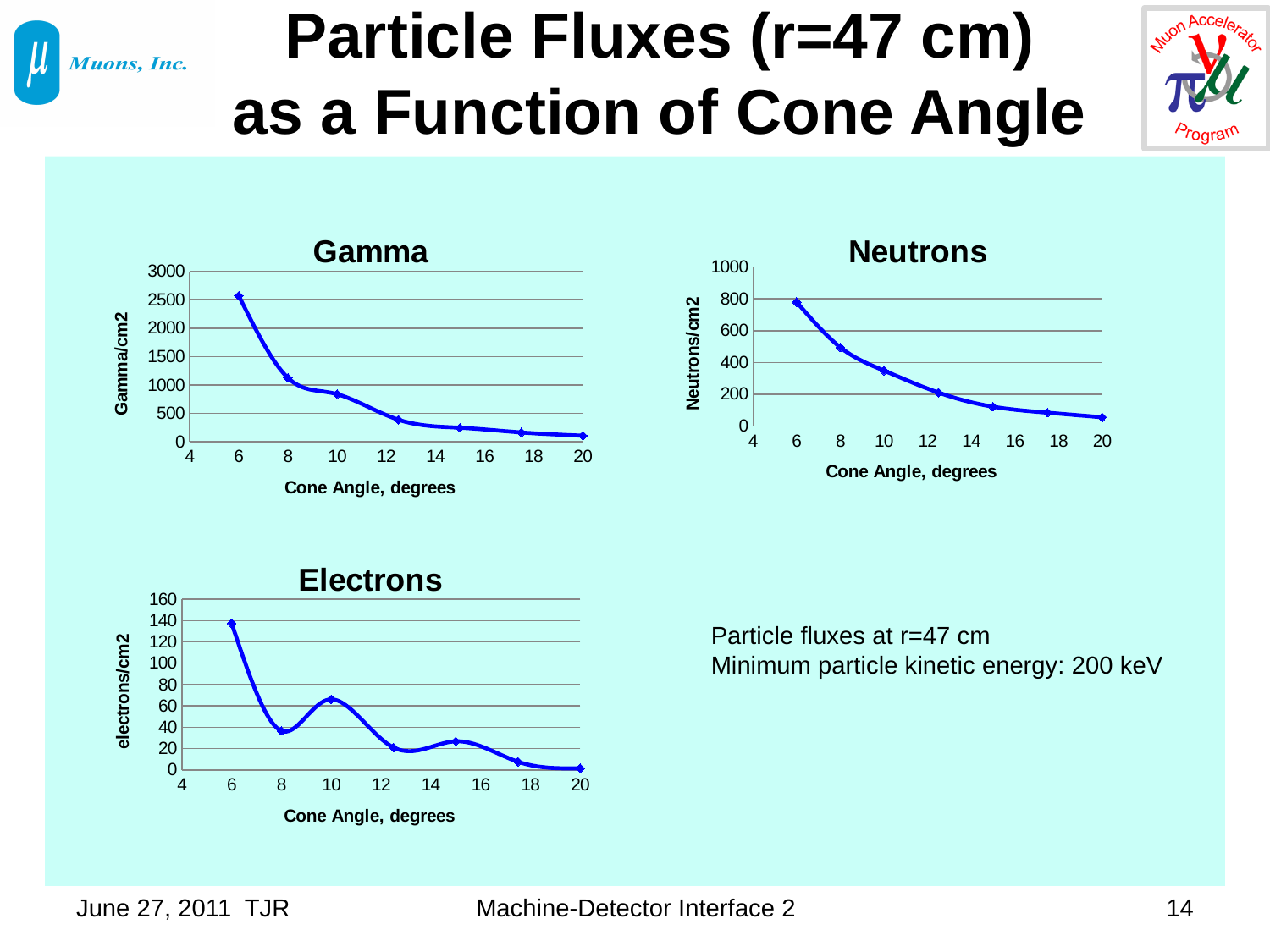
What kind of chart is the Gamma chart? line chart On the Neutrons chart, is the value at a cone angle of 20 degrees greater or less than 200? less On the Electrons chart, is the value at a cone angle of 6 degrees greater or less than 120? greater What is the x-axis label of the Electrons chart? Cone Angle, degrees What is the y-axis label of the Neutrons chart? Neutrons/cm2 How many data points are plotted on the Neutrons chart? 7 On the Electrons chart, which has the larger value: a cone angle of 8 degrees or 10 degrees? 10 degrees On the Neutrons chart, is the value at a cone angle of 6 degrees greater or less than 600? greater On the Gamma chart, at which cone angle is the flux highest? 6 On the Electrons chart, at which cone angle is the flux lowest? 20 On the Gamma chart, do the values rise or fall as the cone angle increases? fall